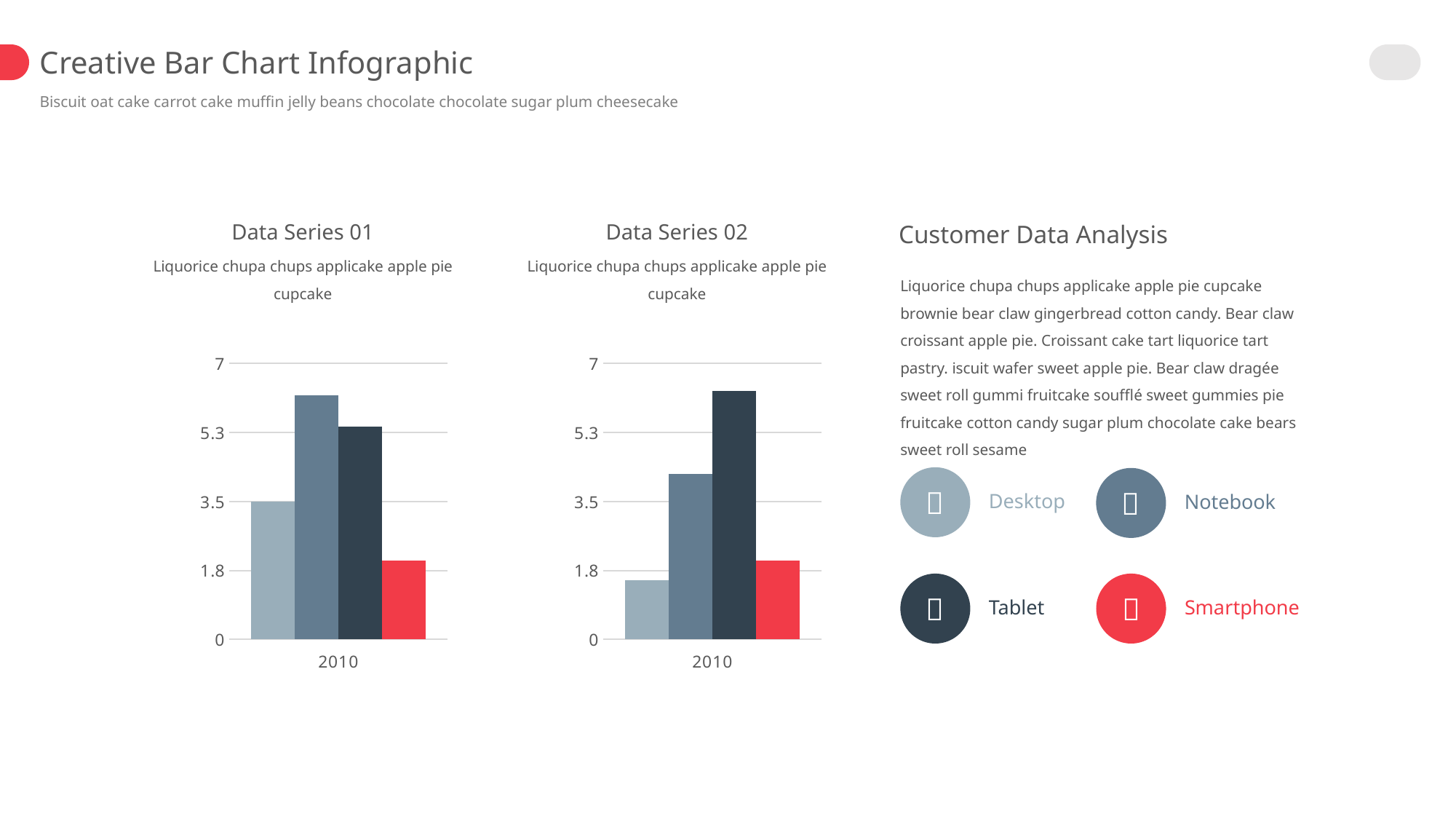
In the Data Series 01 chart, which device has the lowest bar? Smartphone In the Data Series 01 chart, which device has the highest bar? Notebook In the Data Series 01 chart, is the value for Notebook greater or less than 5.3? greater In the Data Series 01 chart, what is the value for Desktop? 3.5 In the Data Series 02 chart, is the value for Desktop greater or less than 1.8? less In the Data Series 01 chart, which is larger, the Tablet bar or the Smartphone bar? Tablet In the Data Series 02 chart, which device has the highest bar? Tablet What year is shown on the x axis of the Data Series 01 chart? 2010 How many bars are plotted in the Data Series 02 chart? 4 In the Data Series 02 chart, which device has the lowest bar? Desktop What kind of chart is the Data Series 01 chart? bar chart In the Data Series 02 chart, is the value for Notebook greater or less than 3.5? greater